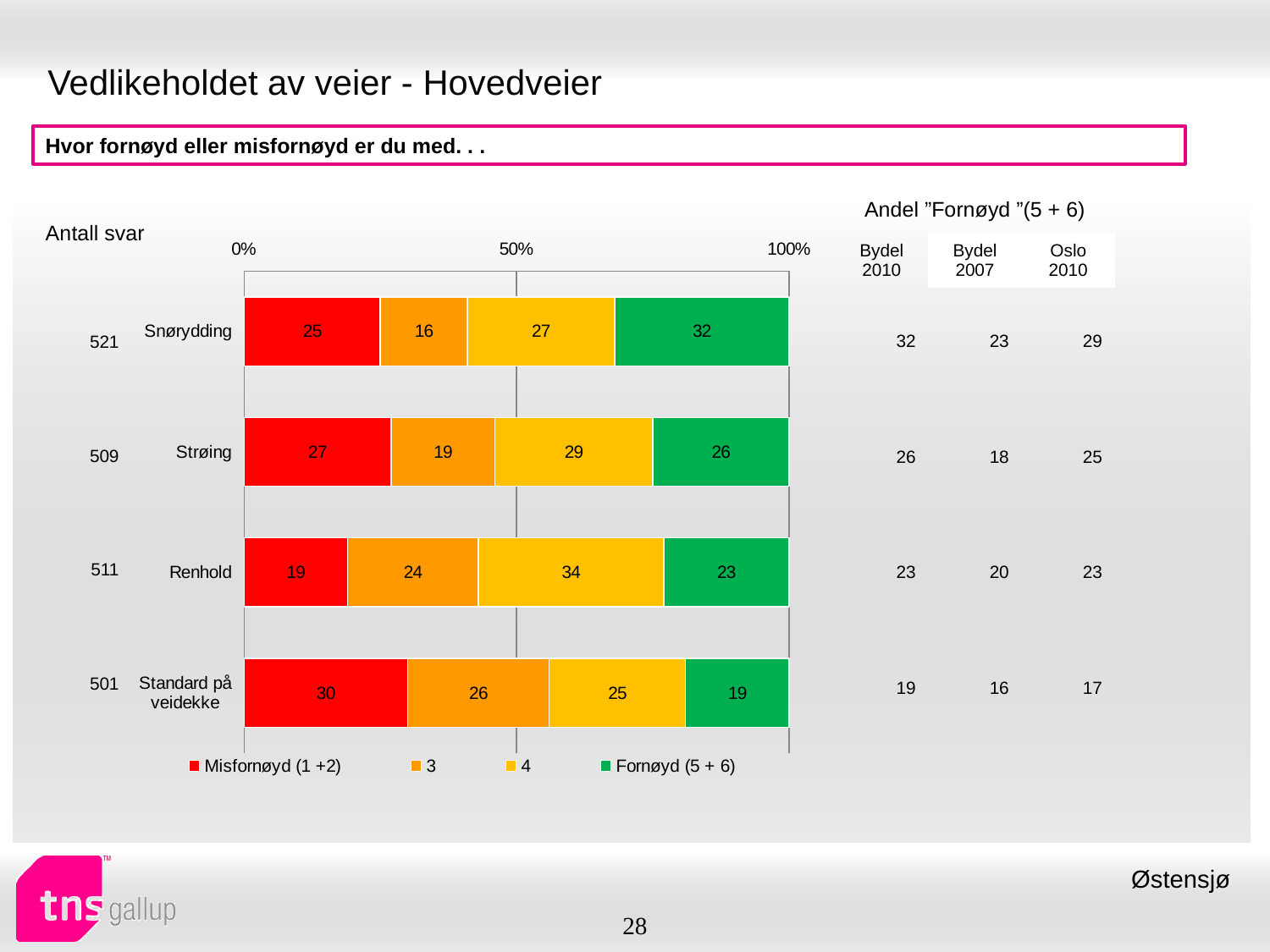
Which category has the lowest Misfornøyd (1 +2) value? Renhold What is the value of the '4' segment for Renhold? 34 What is the value of the Misfornøyd (1 +2) segment for Snørydding? 25 What is the total of the stacked bar for Strøing? 101 What is the value of the '3' segment for Standard på veidekke? 26 How many series does the legend list? 4 What kind of chart is shown on the slide? stacked bar chart What is the difference between the Misfornøyd (1 +2) values for Standard på veidekke and Renhold? 11 What is the value of the Fornøyd (5 + 6) segment for Strøing? 26 Which category has the highest Fornøyd (5 + 6) value? Snørydding Which is larger: the Fornøyd (5 + 6) value for Renhold or for Standard på veidekke? Renhold How many categories are plotted in the chart? 4